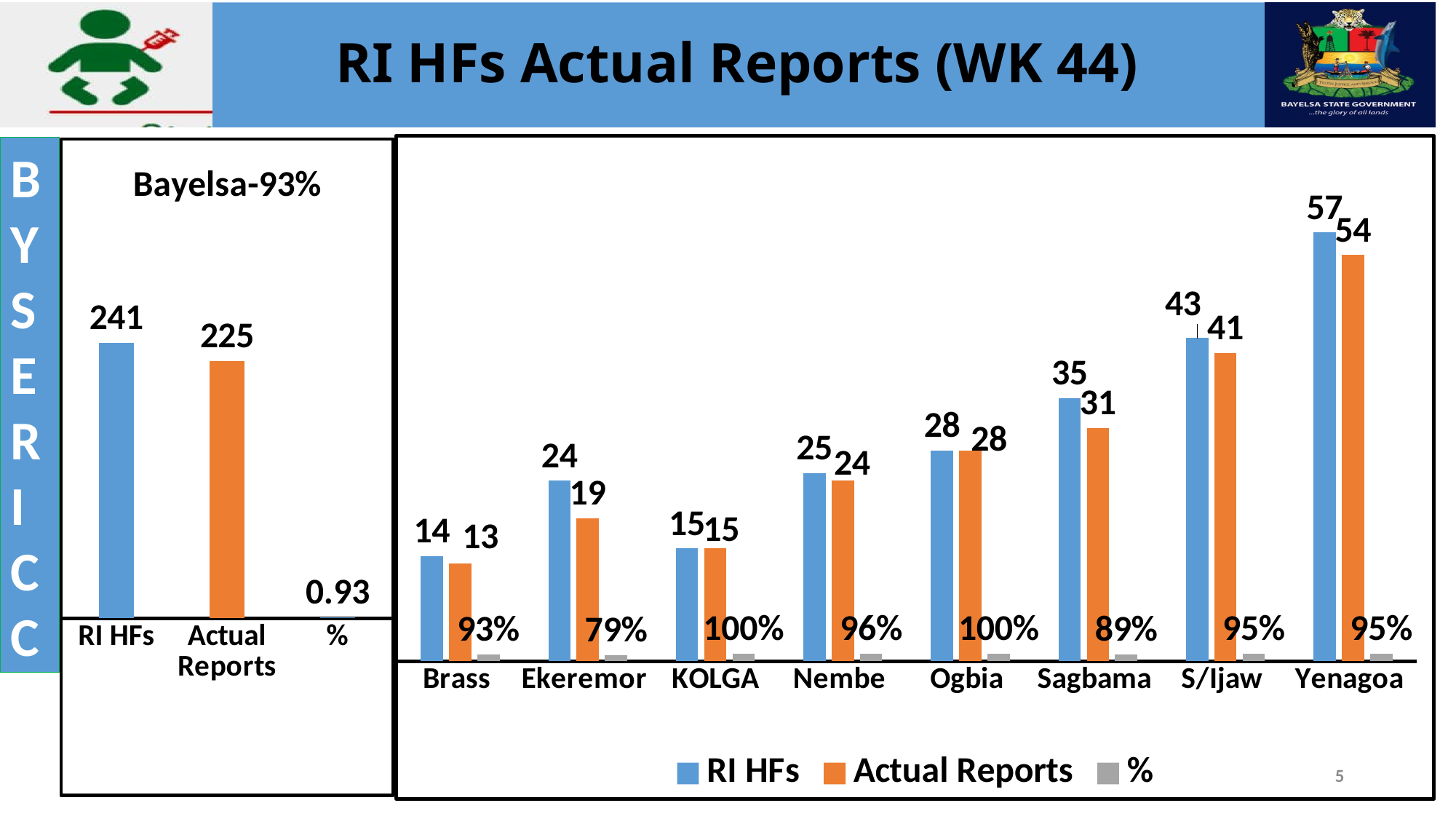
What kind of chart is the right-hand chart? bar chart In the right-hand chart, which is larger for S/Ijaw: RI HFs or Actual Reports? RI HFs In the right-hand chart, what is the difference between RI HFs and Actual Reports for Ekeremor? 5 In the left-hand chart (Bayelsa-93%), what is the value for Actual Reports? 225 How many LGAs are shown on the x axis of the right-hand chart? 8 How many series does the legend of the right-hand chart list? 3 In the right-hand chart, which LGA has the lowest Actual Reports value? Brass In the right-hand chart, what is the Actual Reports value for Ekeremor? 19 In the right-hand chart, what is the RI HFs value for Yenagoa? 57 In the right-hand chart, which LGA has the highest RI HFs value? Yenagoa In the right-hand chart, what percentage is shown for Sagbama? 89% In the left-hand chart (Bayelsa-93%), what is the difference between RI HFs and Actual Reports? 16